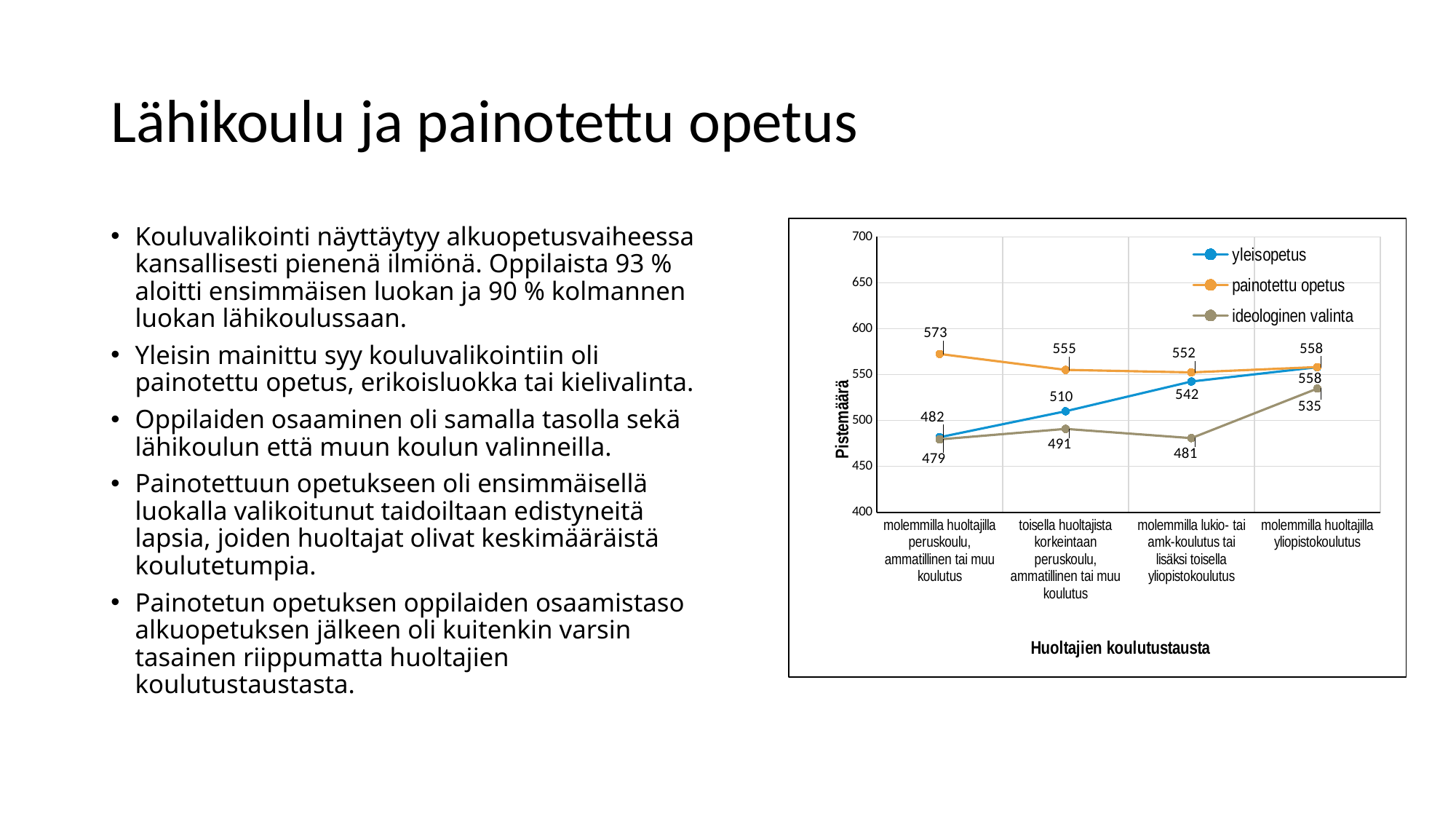
What is the value for ideologinen valinta in the category 'molemmilla huoltajilla yliopistokoulutus'? 535 What is the value for yleisopetus in the category 'toisella huoltajista korkeintaan peruskoulu, ammatillinen tai muu koulutus'? 510 What is the value for painotettu opetus in the category 'molemmilla huoltajilla peruskoulu, ammatillinen tai muu koulutus'? 573 What is the difference between painotettu opetus and yleisopetus in the category 'molemmilla huoltajilla peruskoulu, ammatillinen tai muu koulutus'? 91 In which category is the value for painotettu opetus highest? molemmilla huoltajilla peruskoulu, ammatillinen tai muu koulutus Does the yleisopetus series rise or fall across the categories from left to right? rise In which category is the value for yleisopetus lowest? molemmilla huoltajilla peruskoulu, ammatillinen tai muu koulutus What kind of chart is shown on the slide? line chart How many categories are shown on the x axis of the chart? 4 What is the value for ideologinen valinta in the category 'molemmilla lukio- tai amk-koulutus tai lisäksi toisella yliopistokoulutus'? 481 How many series does the chart legend list? 3 Which is larger in the category 'toisella huoltajista korkeintaan peruskoulu, ammatillinen tai muu koulutus': yleisopetus or ideologinen valinta? yleisopetus